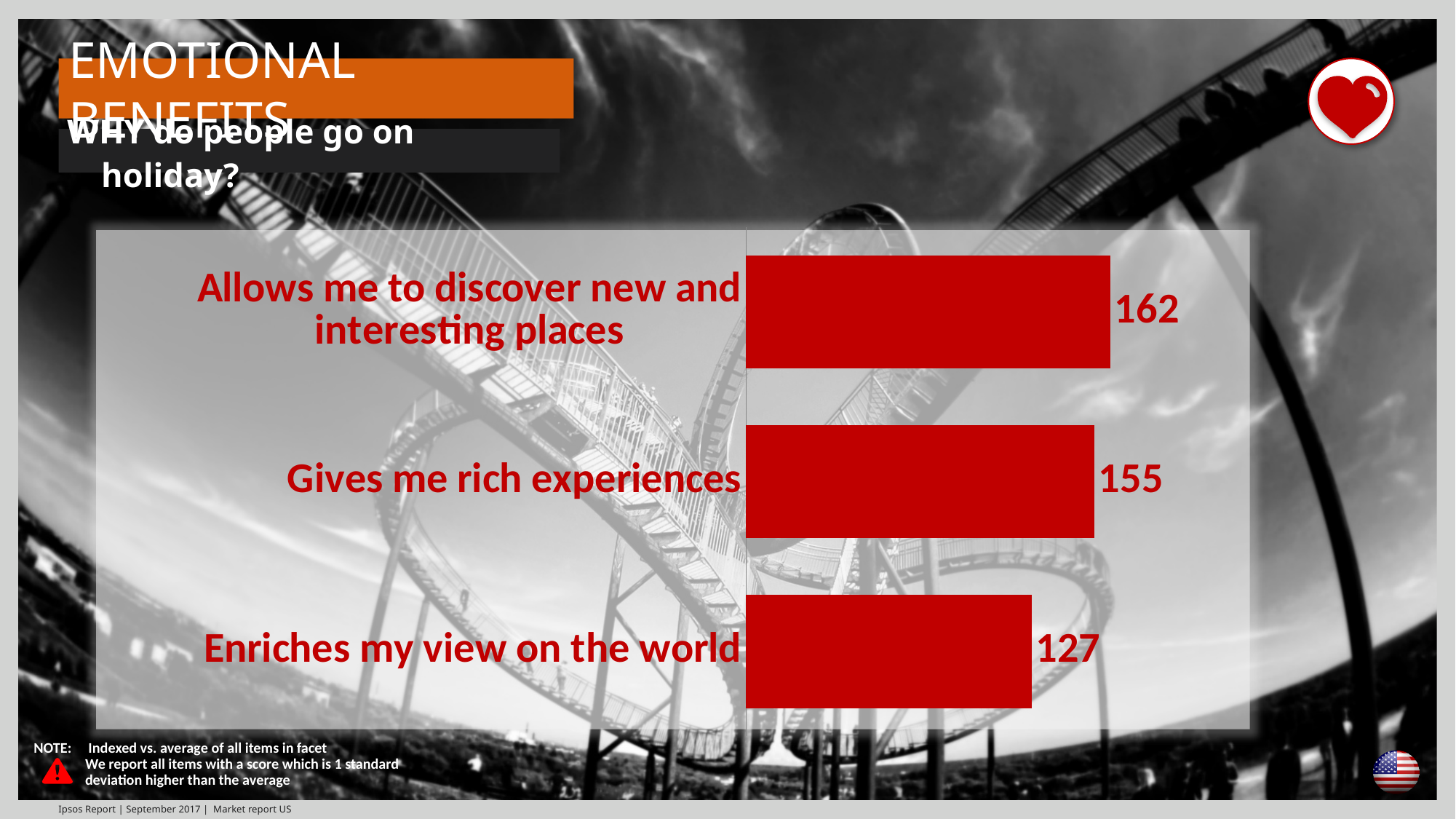
What question does the chart address, according to the slide subtitle? WHY do people go on holiday? What kind of chart is shown on the slide? Bar chart What is the value for "Enriches my view on the world"? 127 Which category has the lowest value? Enriches my view on the world What is the value for "Gives me rich experiences"? 155 What colour are the bars in the chart? Red Which is larger: the value for "Gives me rich experiences" or the value for "Enriches my view on the world"? Gives me rich experiences What is the difference between the values for "Gives me rich experiences" and "Enriches my view on the world"? 28 What is the value for "Allows me to discover new and interesting places"? 162 Which category has the highest value? Allows me to discover new and interesting places What is the difference between the values for "Allows me to discover new and interesting places" and "Enriches my view on the world"? 35 How many categories are shown in the chart? 3